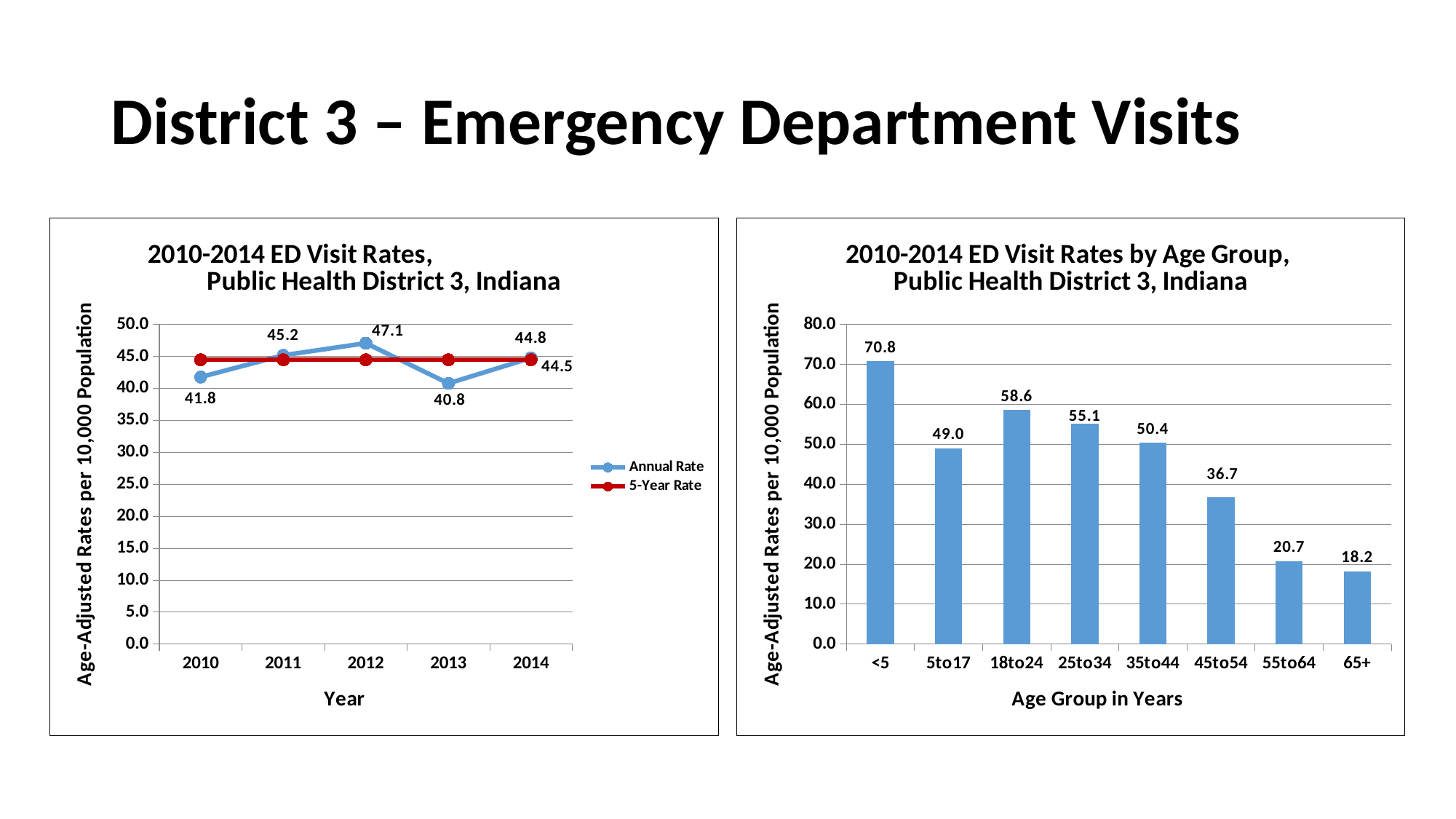
In the left chart (2010-2014 ED Visit Rates), what is the Annual Rate for 2012? 47.1 In the right chart (ED Visit Rates by Age Group), which age group has the lowest rate? 65+ In the left chart (2010-2014 ED Visit Rates), what kind of chart is it? Line chart In the left chart (2010-2014 ED Visit Rates), what is the 5-Year Rate? 44.5 In the right chart (ED Visit Rates by Age Group), what is the value for the 45to54 age group? 36.7 In the right chart (ED Visit Rates by Age Group), which is larger, the value for 18to24 or for 25to34? 18to24 In the right chart (ED Visit Rates by Age Group), what is the difference between the values for 55to64 and 65+? 2.5 In the right chart (ED Visit Rates by Age Group), how many age groups are shown? 8 In the right chart (ED Visit Rates by Age Group), which age group has the highest rate? <5 In the left chart (2010-2014 ED Visit Rates), what is the difference between the Annual Rate in 2012 and in 2010? 5.3 In the left chart (2010-2014 ED Visit Rates), how many series does the legend list? 2 In the left chart (2010-2014 ED Visit Rates), which year has the lowest Annual Rate? 2013